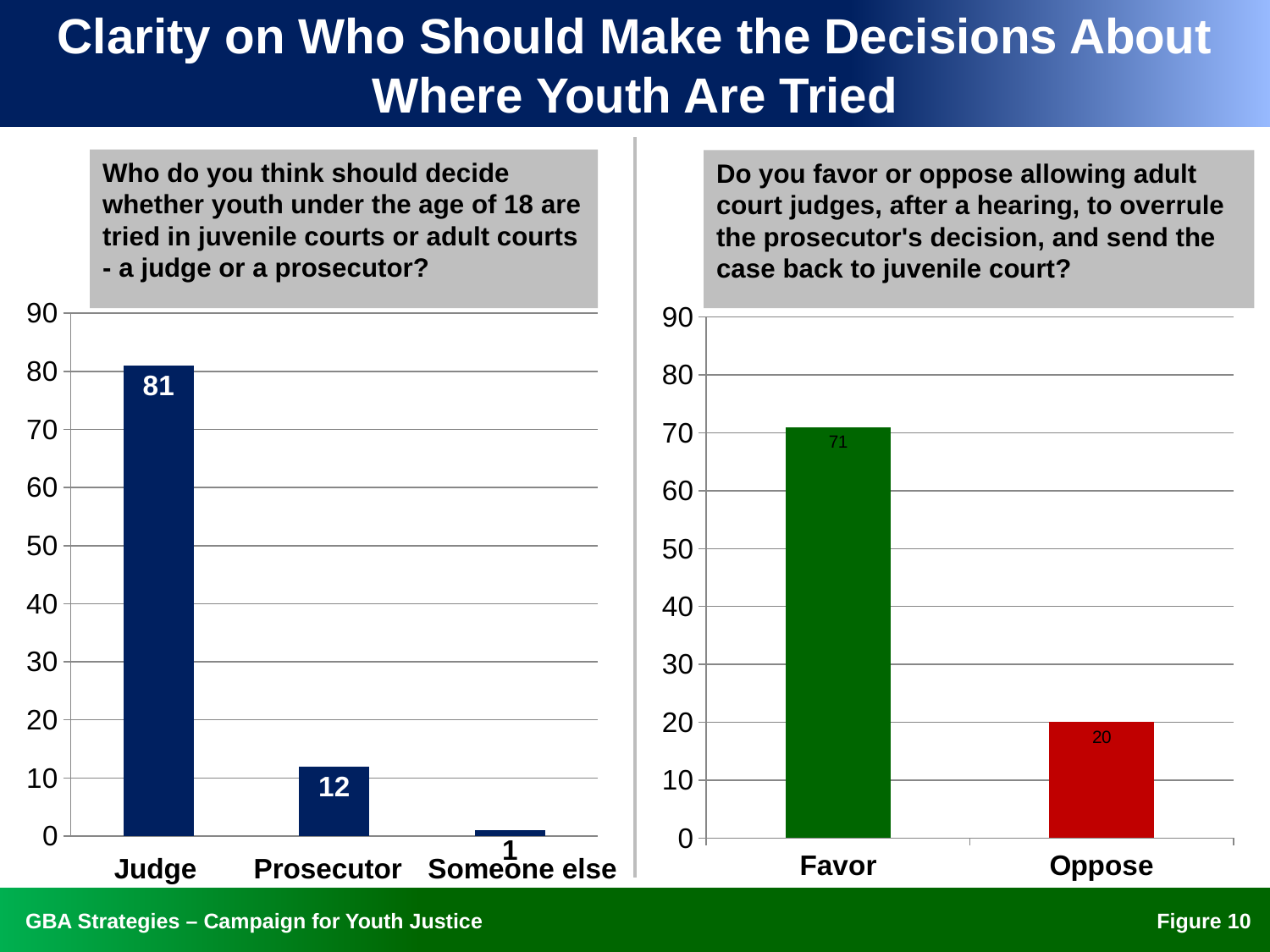
In the left chart, what is the value for Prosecutor? 12 What kind of chart is the right chart? Bar chart In the right chart, what is the value for Oppose? 20 How many categories does the left chart show? 3 In the left chart, which category has the highest value? Judge In the right chart, what is the difference between the values for Favor and Oppose? 51 In the left chart, what is the value for Someone else? 1 In the left chart, what is the value for Judge? 81 In the left chart, which category has the lowest value? Someone else In the right chart, which is larger, Favor or Oppose? Favor In the left chart, what is the difference between the values for Judge and Prosecutor? 69 In the right chart, what is the value for Favor? 71